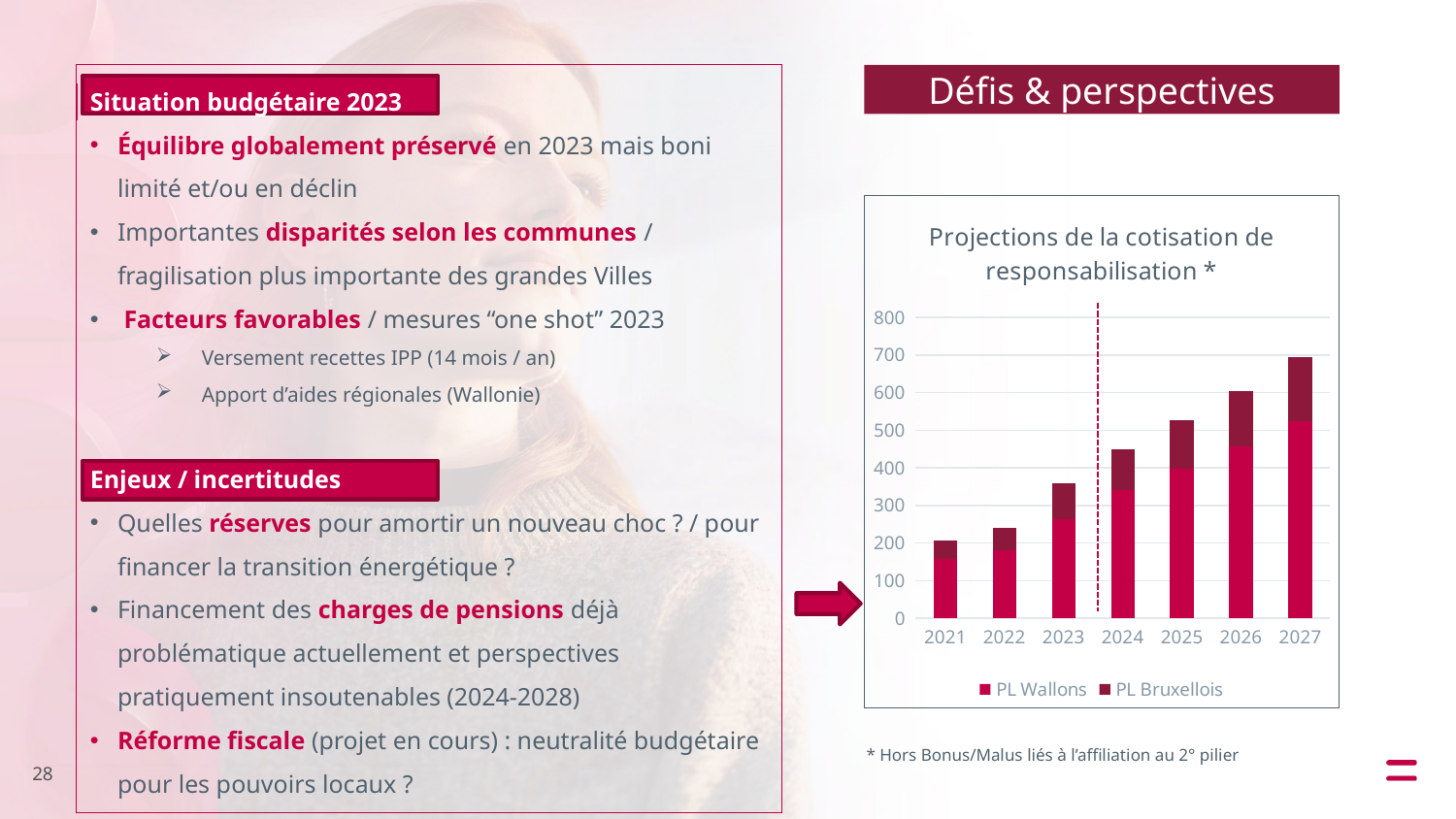
Which year has the lowest total bar in the chart? 2021 How many years are shown on the x axis of the chart? 7 Is the total bar for 2024 greater or less than 500? less Which year has the larger total bar, 2022 or 2026? 2026 Do the total bar values rise or fall from 2021 to 2027? Rise How many series does the chart legend list? 2 What is the title of the chart? Projections de la cotisation de responsabilisation * Which year has the highest total bar in the chart? 2027 Is the total bar for 2027 greater or less than 600? greater Is the total bar for 2021 greater or less than 300? less What kind of chart is shown on the slide? Stacked bar chart Which series are listed in the chart legend? PL Wallons and PL Bruxellois